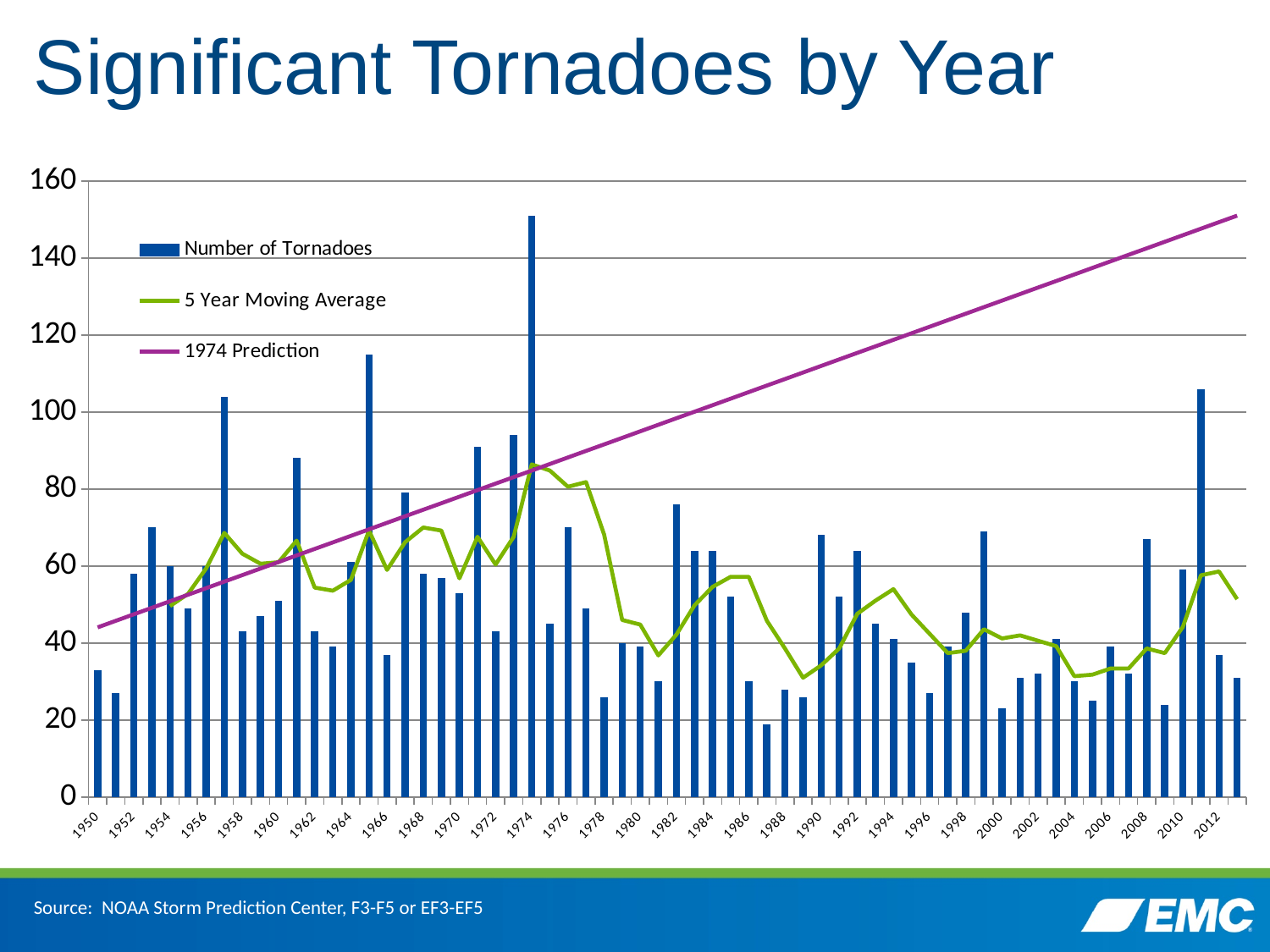
Which year has the larger Number of Tornadoes, 1974 or 2011? 1974 What is the name of the series drawn as a green line? 5 Year Moving Average Which year has the highest Number of Tornadoes? 1974 How many series does the legend list? 3 What kind of chart is used to show the Number of Tornadoes series? bar chart Does the 1974 Prediction line rise or fall from left to right across the years? rises Is the Number of Tornadoes for 2011 greater or less than 100? greater Which year has the larger Number of Tornadoes, 1961 or 1982? 1961 Is the Number of Tornadoes for 1974 greater or less than 140? greater Is the Number of Tornadoes for 1965 greater or less than 100? greater